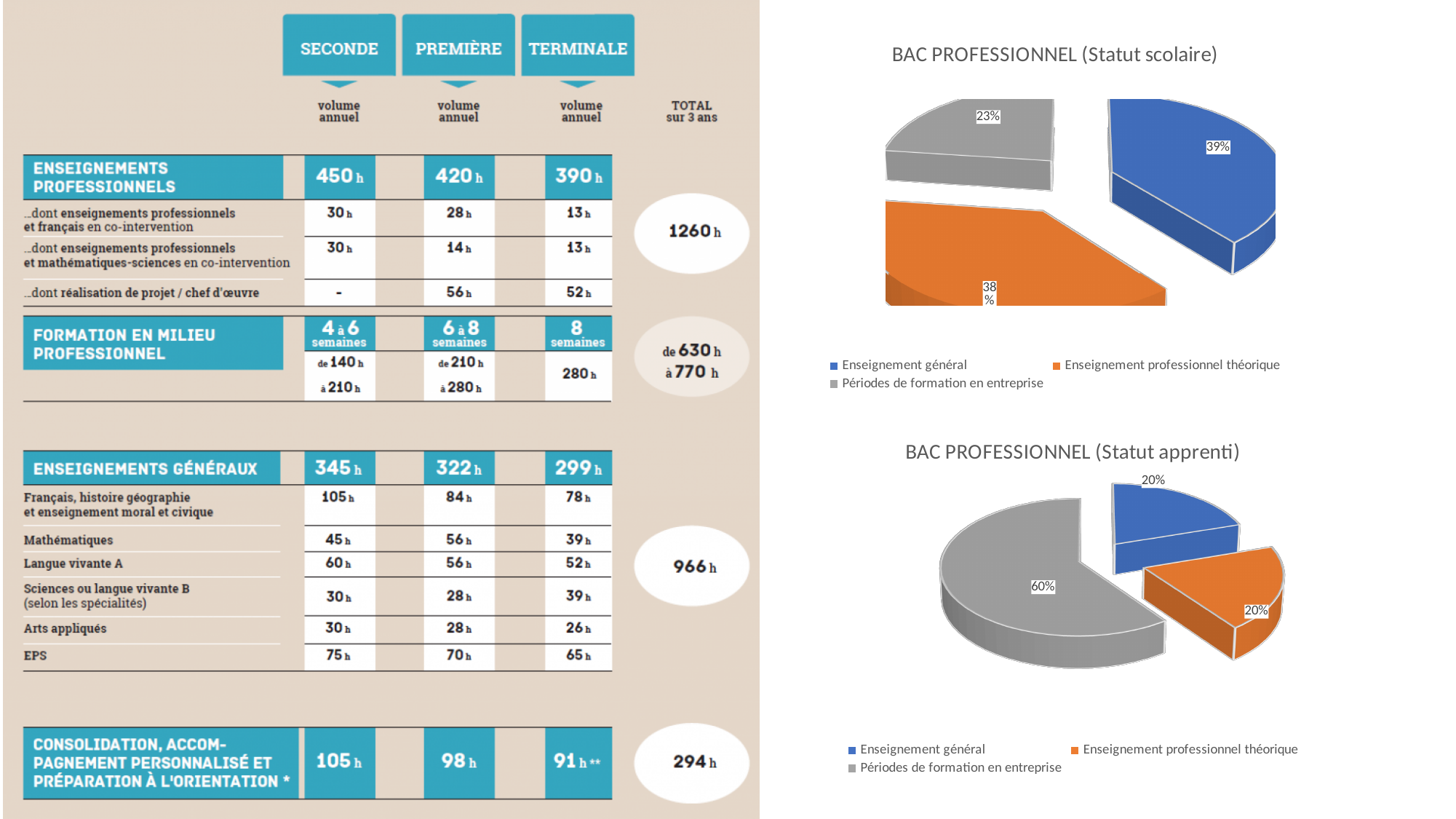
In the 'BAC PROFESSIONNEL (Statut scolaire)' chart, which category has the smallest slice? Périodes de formation en entreprise In the 'BAC PROFESSIONNEL (Statut scolaire)' chart, what is the difference in percentage points between Enseignement général and Périodes de formation en entreprise? 16 In the 'BAC PROFESSIONNEL (Statut scolaire)' chart, what share is Enseignement professionnel théorique? 38% In the 'BAC PROFESSIONNEL (Statut scolaire)' chart, what share is Enseignement général? 39% How many slices does the 'BAC PROFESSIONNEL (Statut apprenti)' pie chart have? 3 In the 'BAC PROFESSIONNEL (Statut scolaire)' chart, which colour represents Enseignement professionnel théorique? orange In the 'BAC PROFESSIONNEL (Statut scolaire)' chart, what share is Périodes de formation en entreprise? 23% In the 'BAC PROFESSIONNEL (Statut apprenti)' chart, which category has the largest slice? Périodes de formation en entreprise What kind of chart is the 'BAC PROFESSIONNEL (Statut scolaire)' chart? pie chart What is the difference in percentage points between Périodes de formation en entreprise in the 'Statut apprenti' chart and in the 'Statut scolaire' chart? 37 In the 'BAC PROFESSIONNEL (Statut apprenti)' chart, what share is Enseignement général? 20% In the 'BAC PROFESSIONNEL (Statut apprenti)' chart, what share is Périodes de formation en entreprise? 60%